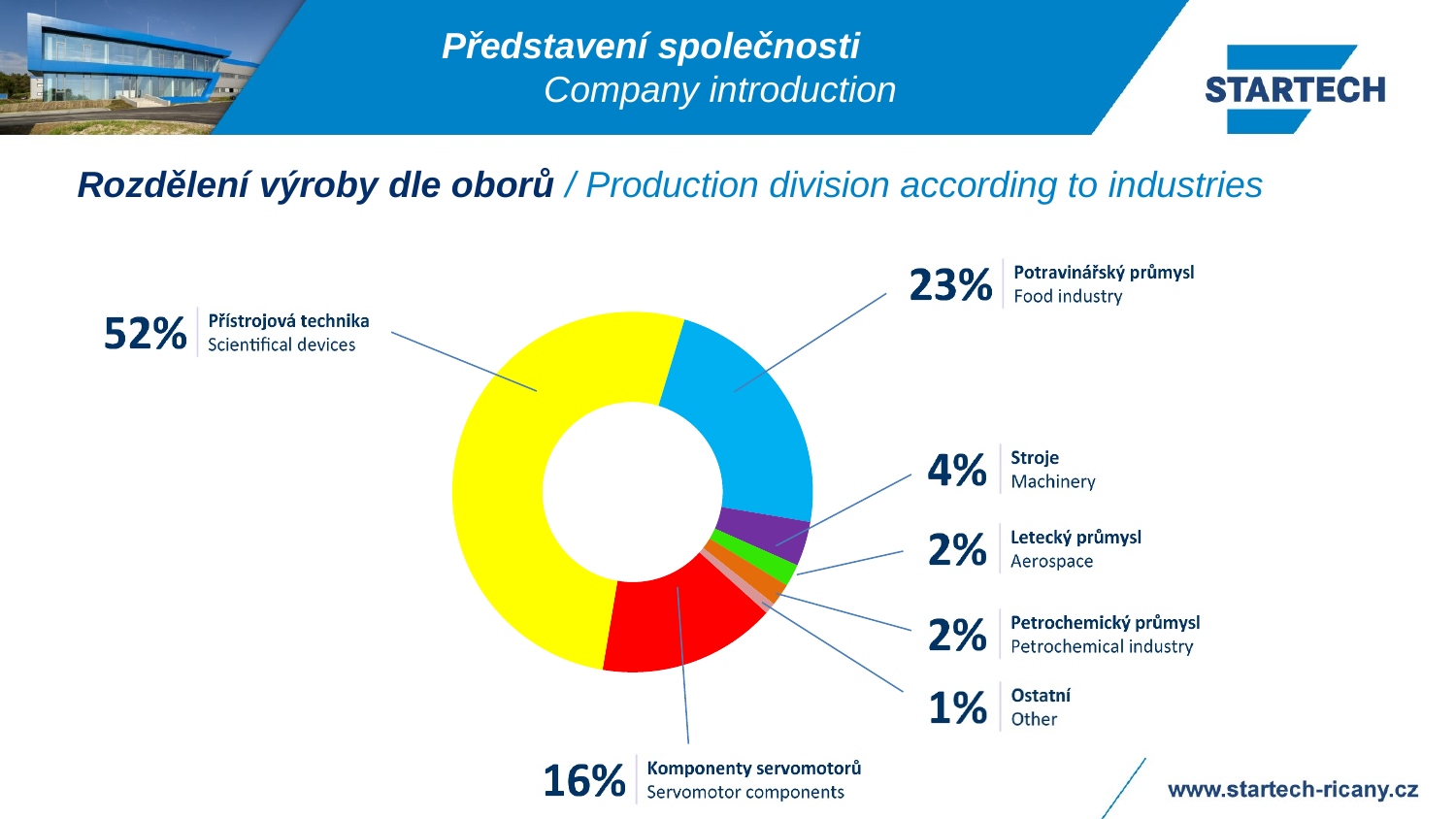
What colour is the slice representing Scientifical devices? Yellow What share of production is attributed to Servomotor components (Komponenty servomotorů)? 16% What share of production is attributed to Other (Ostatní)? 1% What share of production is attributed to Machinery (Stroje)? 4% What kind of chart is used to show the production division according to industries? Pie chart (donut) What share of production is attributed to Scientifical devices (Přístrojová technika)? 52% What is the difference in percentage points between the Scientifical devices share and the Food industry share? 29 Which industry has the largest share of production? Scientifical devices (Přístrojová technika) Which has a larger share of production, Servomotor components or Machinery? Servomotor components What share of production is attributed to the Food industry (Potravinářský průmysl)? 23% How many industry categories are shown in the chart? 7 Which category has the smallest share of production? Other (Ostatní)